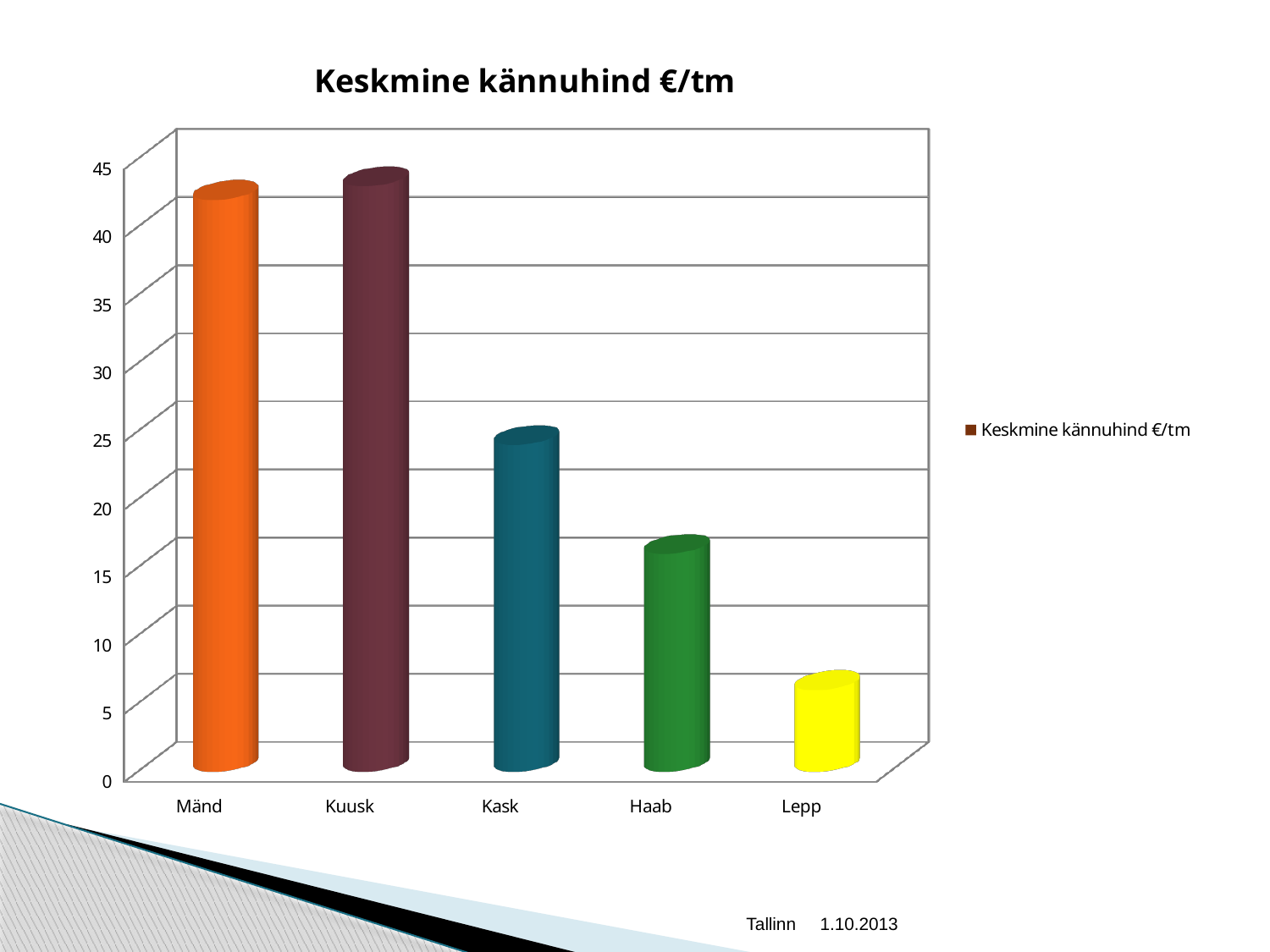
How many categories are shown on the x axis of the chart? 5 Which category has the lowest value? Lepp Is the value for Lepp greater or less than 10? less Do the values rise or fall from Kuusk to Lepp along the x axis? fall Is the value for Kask greater or less than 20? greater Is the value for Haab greater or less than 20? less Which has the larger value, Kask or Haab? Kask What is the title of the chart? Keskmine kännuhind €/tm What kind of chart is shown on the slide? bar chart Which has the larger value, Haab or Lepp? Haab How many series does the legend list? 1